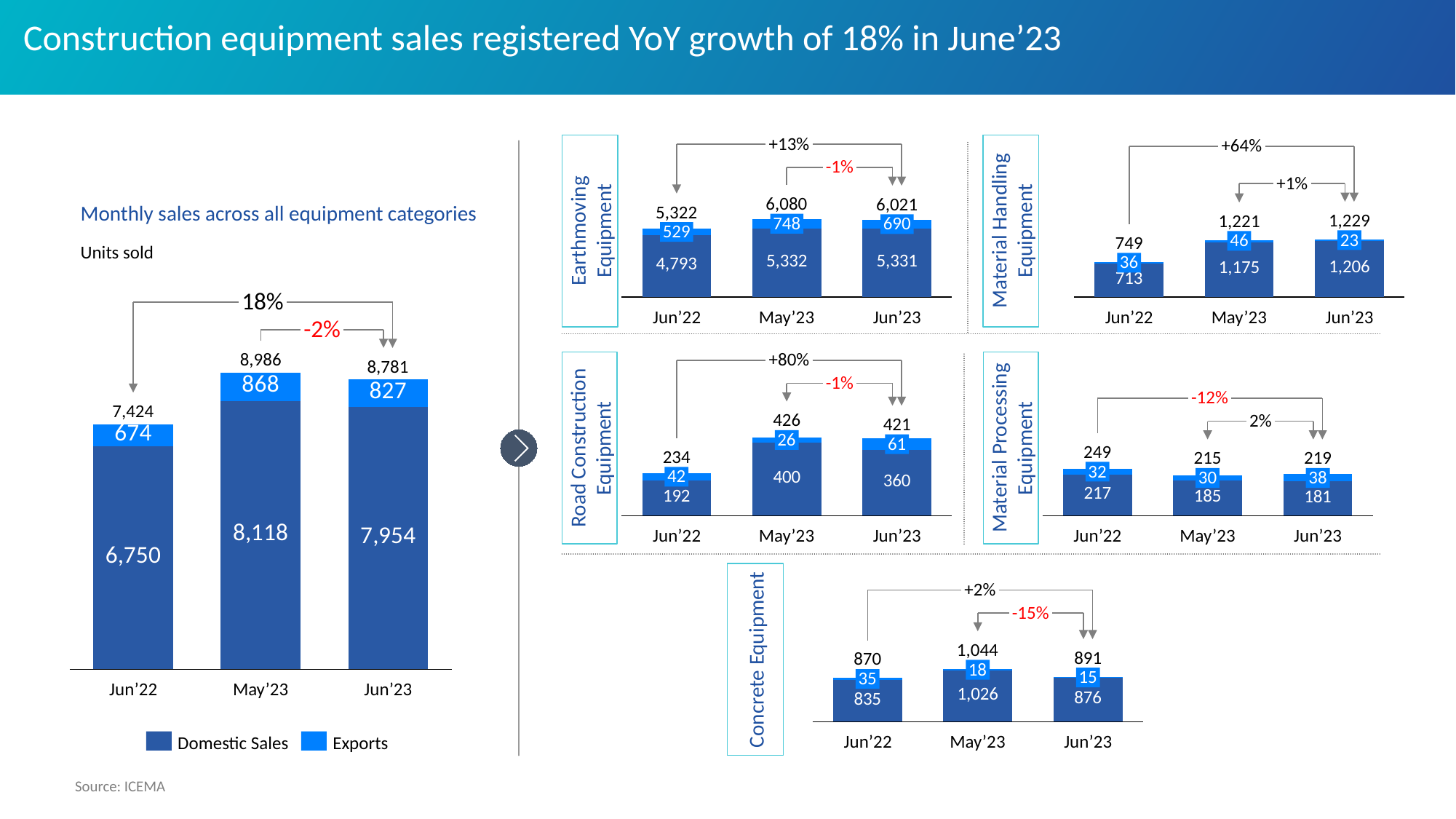
In the Earthmoving Equipment chart, what is the Exports value for May'23? 748 In the Material Handling Equipment chart, what is the total for Jun'23? 1,229 In the 'Monthly sales across all equipment categories' chart, what is the Domestic Sales value for Jun'23? 7,954 In the Concrete Equipment chart, is the total for May'23 larger or smaller than the total for Jun'23? Larger In the Road Construction Equipment chart, which month has the highest total? May'23 In the 'Monthly sales across all equipment categories' chart, what is the total units sold for May'23? 8,986 In the 'Monthly sales across all equipment categories' chart, which month has the lowest total units sold? Jun'22 In the 'Monthly sales across all equipment categories' chart, what is the difference between Exports in May'23 and Exports in Jun'23? 41 In the Material Processing Equipment chart, what is the Domestic Sales value for Jun'22? 217 How many series does the legend of the 'Monthly sales across all equipment categories' chart list? 2 What kind of chart is the 'Monthly sales across all equipment categories' chart? Stacked bar chart In the Concrete Equipment chart, what is the difference between Domestic Sales in May'23 and Domestic Sales in Jun'22? 191